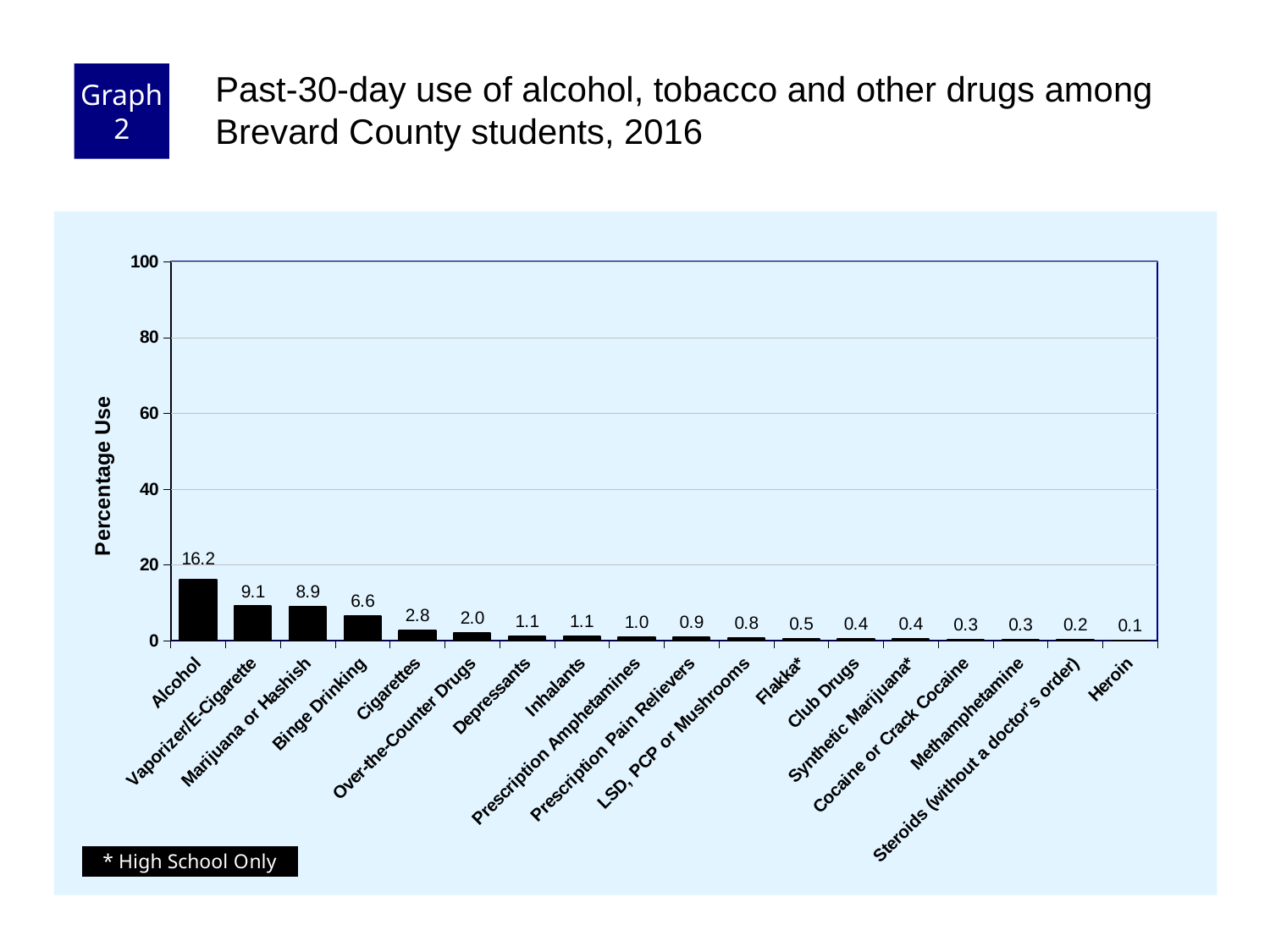
Which category has the lowest percentage use? Heroin What is the label of the y axis? Percentage Use What is the percentage use for Vaporizer/E-Cigarette? 9.1 What is the percentage use for Cigarettes? 2.8 What kind of chart is shown on the slide? bar chart Is the value for Alcohol greater or less than 20? less What is the difference in percentage use between Alcohol and Marijuana or Hashish? 7.3 Which category has the highest percentage use? Alcohol Which has a higher percentage use, Cigarettes or Over-the-Counter Drugs? Cigarettes What is the percentage use for Alcohol? 16.2 What is the percentage use for Binge Drinking? 6.6 How many categories are shown on the x axis? 18